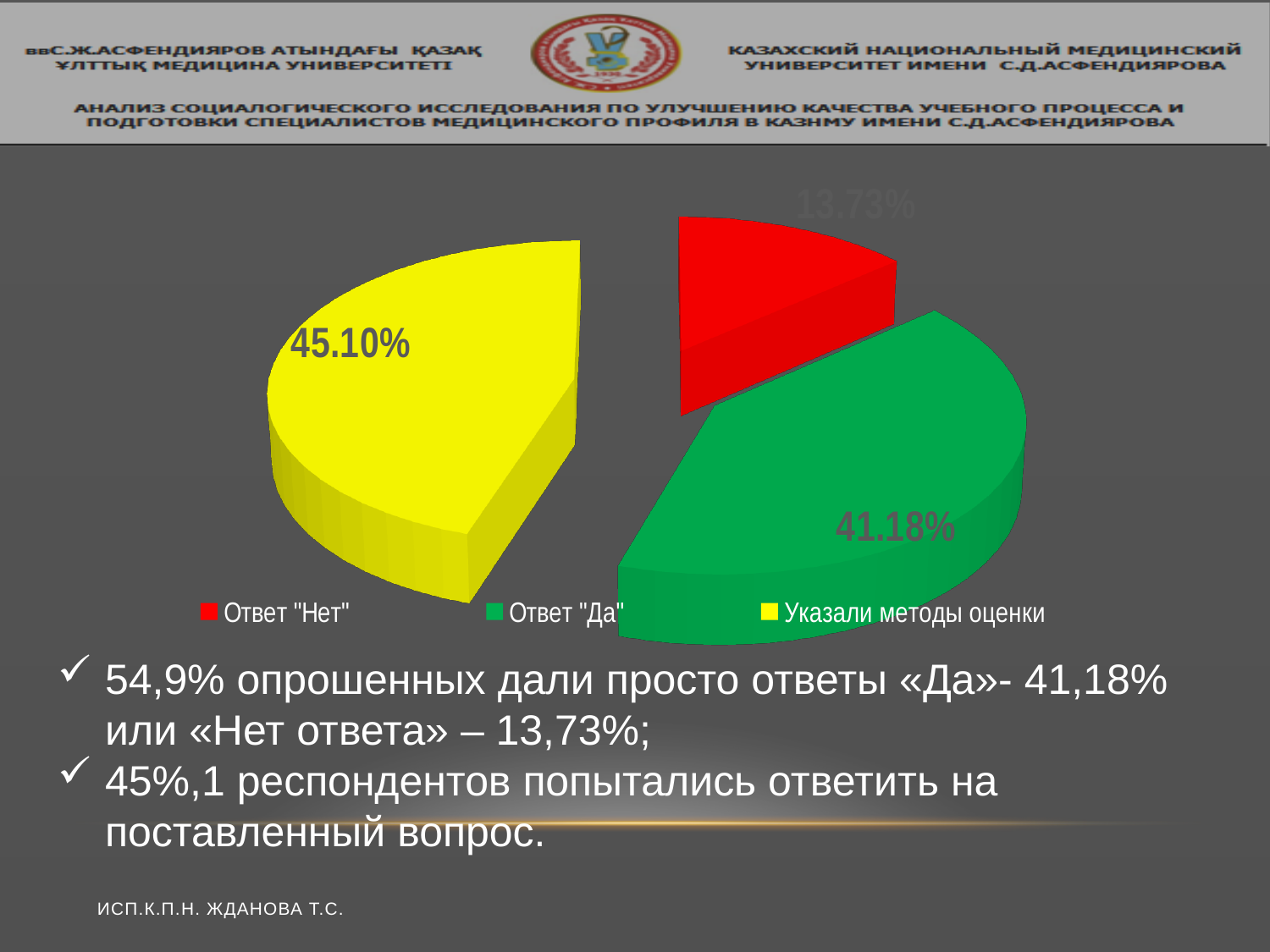
Which category has the largest slice of the pie? Указали методы оценки What share of the pie does the slice "Ответ "Да"" represent? 41.18% How many slices does the pie chart have? 3 What kind of chart is shown on the slide? pie chart Which category has the smallest slice of the pie? Ответ "Нет" What share of the pie does the slice "Указали методы оценки" represent? 45.10% What colour is the slice for "Ответ "Нет""? red What share of the pie does the slice "Ответ "Нет"" represent? 13.73% Which is larger, the slice for "Ответ "Да"" or the slice for "Ответ "Нет""? Ответ "Да" What is the difference between the shares of "Ответ "Да"" and "Ответ "Нет""? 27.45% What is the difference between the shares of "Указали методы оценки" and "Ответ "Да""? 3.92% How many entries does the legend list? 3